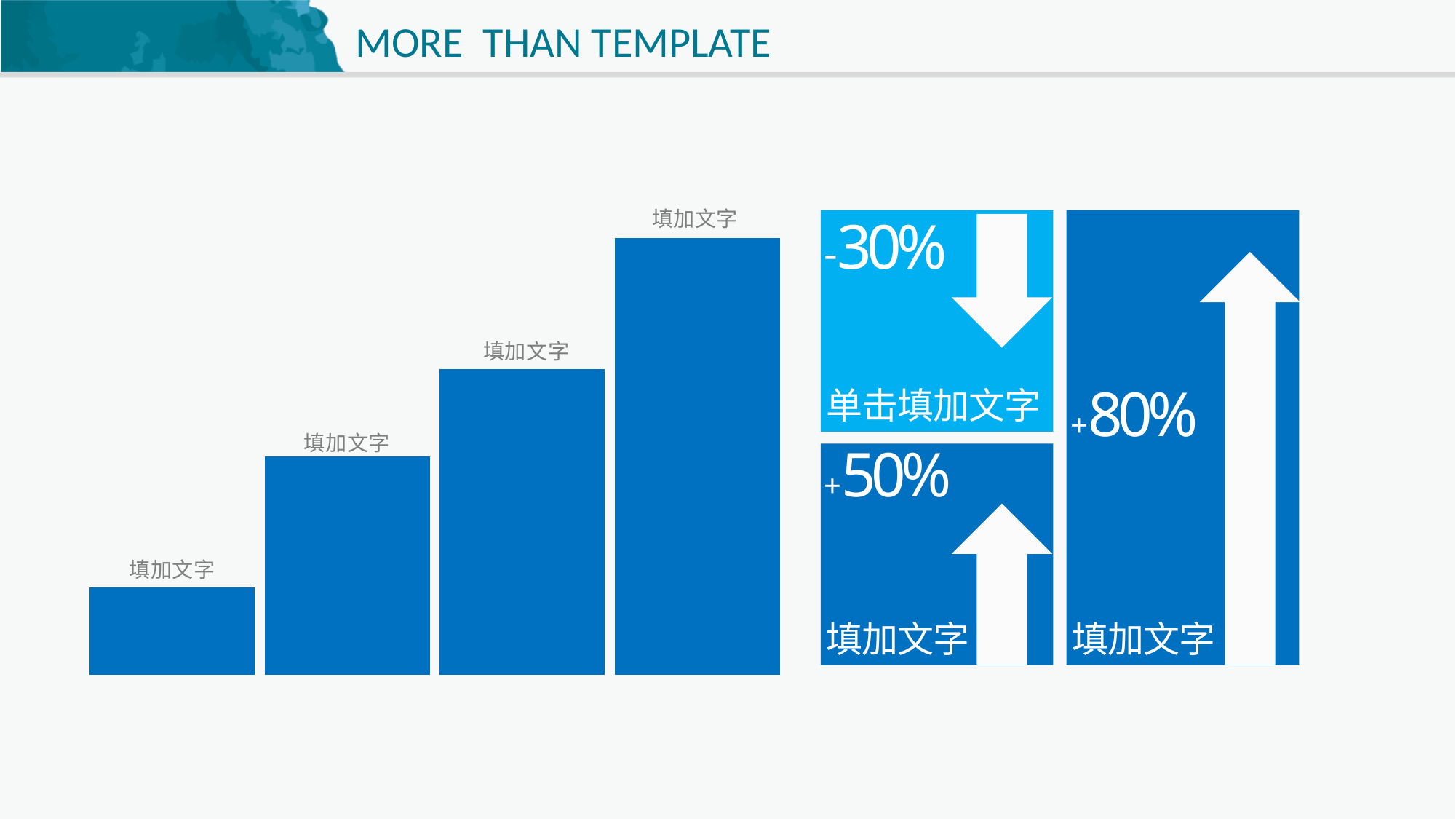
Which bar in the bar chart is the shortest: the first, second, third or fourth from the left? first In the bar chart, is the leftmost bar or the rightmost bar taller? rightmost How many bars does the bar chart on the left of the slide have? 4 In the bar chart, is the second bar from the left taller or shorter than the third bar from the left? shorter Which bar in the bar chart is the tallest: the first, second, third or fourth from the left? fourth What colour are the bars in the bar chart? blue Do the bar heights in the bar chart rise or fall from left to right? rise What kind of chart is shown on the left side of the slide? bar chart What label text appears above each bar in the bar chart? 填加文字